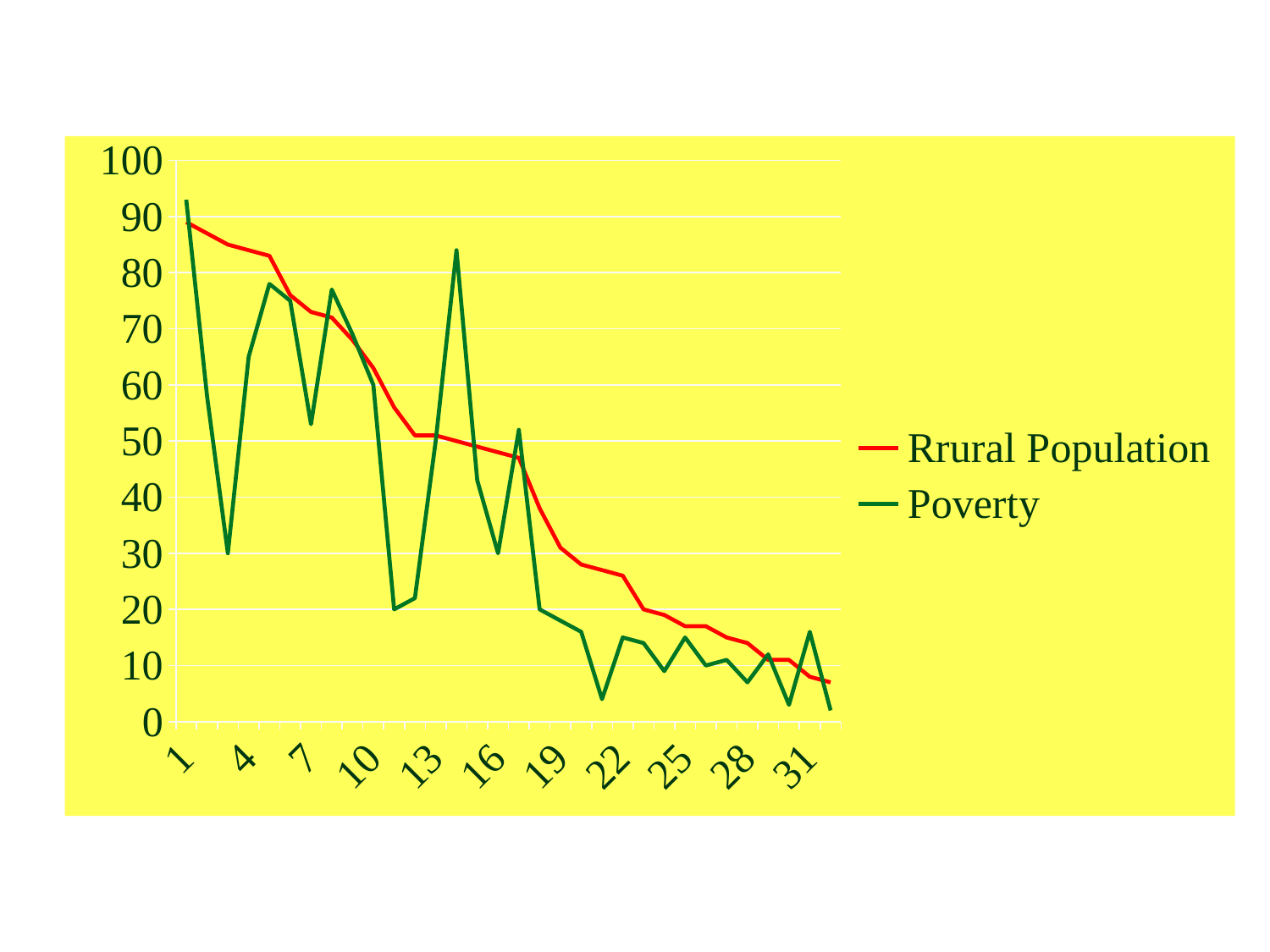
Is the value for Poverty at 5 greater or less than 70? greater Which series is drawn with the green line? Poverty Is the value for Poverty at 14 greater or less than 80? greater Do the Rrural Population values rise or fall along the x axis? fall Which series is drawn with the red line? Rrural Population How many series does the legend list? 2 At x = 14, which series has the larger value, Rrural Population or Poverty? Poverty What kind of chart is shown on the slide? line chart Is the value for Poverty at 21 greater or less than 10? less At x = 3, which series has the larger value, Rrural Population or Poverty? Rrural Population